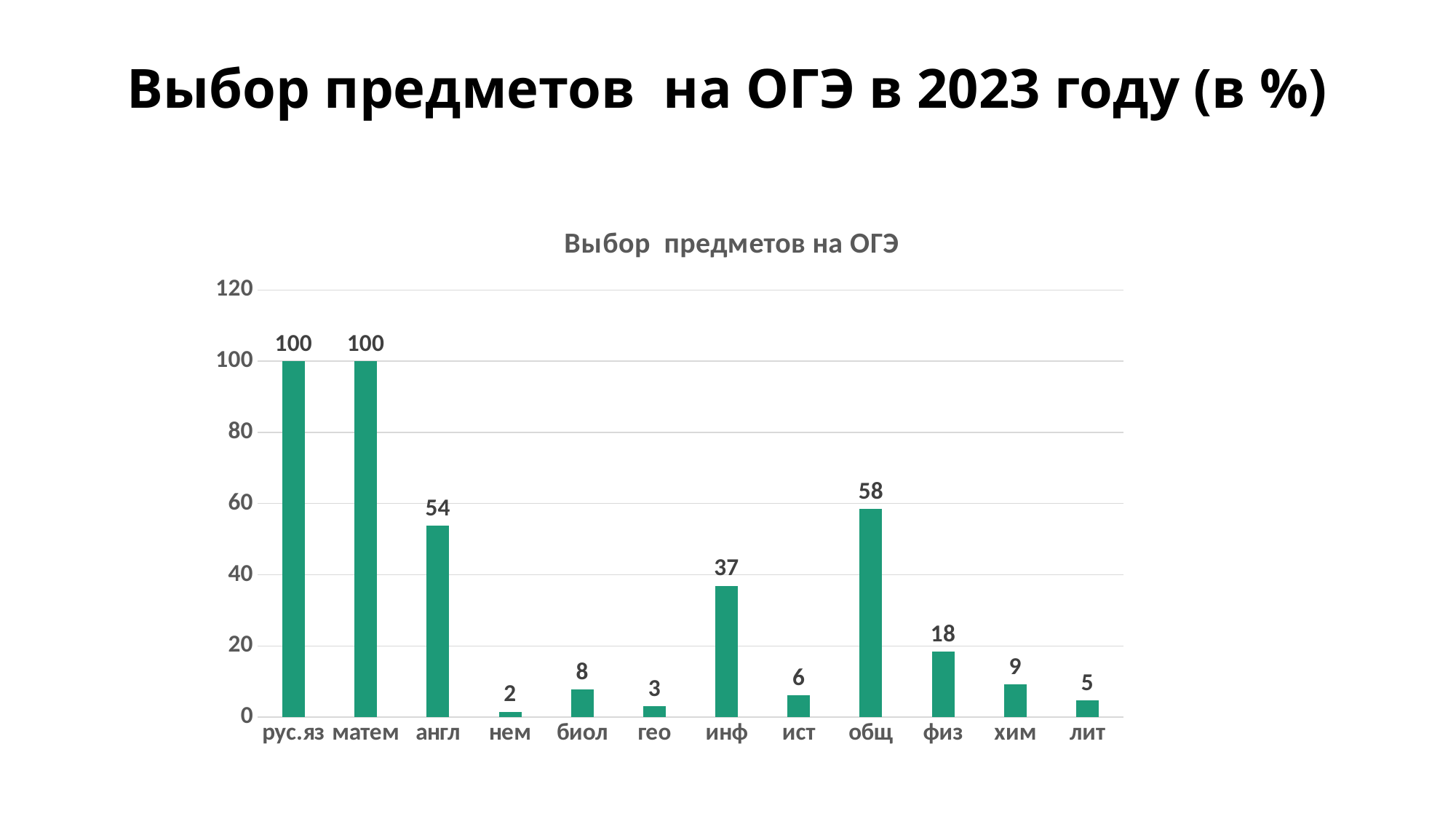
How many categories are shown on the x axis? 12 What is the value for общ? 58 What is the difference between the values for общ and англ? 4 What kind of chart is shown on the slide? bar chart Which is larger, the value for биол or the value for гео? биол What is the difference between the values for хим and лит? 4 What is the value for англ? 54 What is the value for физ? 18 Which category has the lowest value? нем What is the value for инф? 37 Which is larger, the value for инф or the value for физ? инф What is the title of the chart? Выбор предметов на ОГЭ